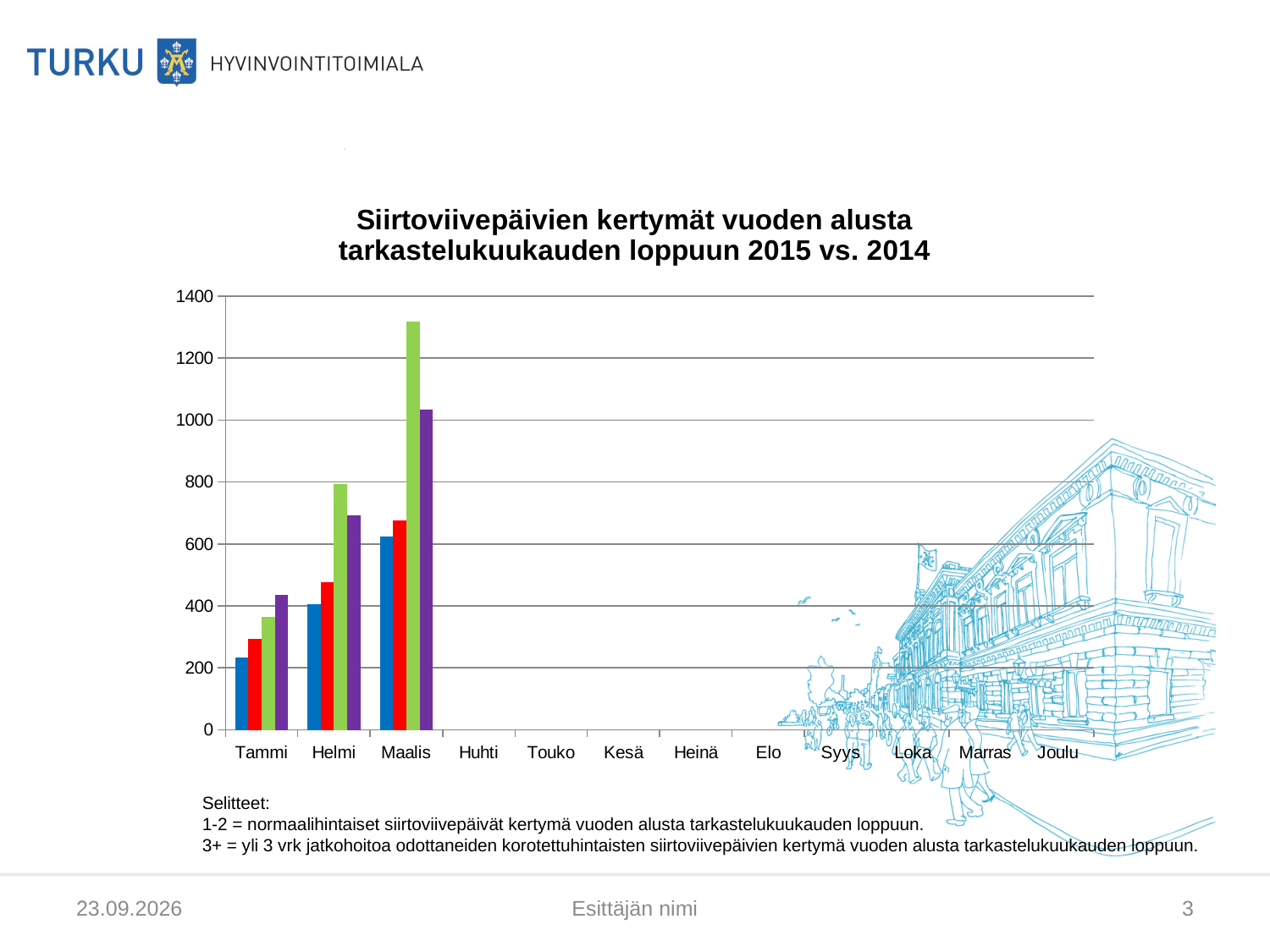
Is the value of the green bar for Maalis greater or less than 1200? greater What is the title of the chart? Siirtoviivepäivien kertymät vuoden alusta tarkastelukuukauden loppuun 2015 vs. 2014 Among the months with data, which month has the lowest bars? Tammi Is the value of the blue bar for Tammi greater or less than 400? less How many months have bars plotted in the chart? 3 Is the value of the blue bar for Maalis greater or less than 400? greater How many month categories are shown on the x axis? 12 What kind of chart is shown on the slide? bar chart Which month has the tallest bar in the chart? Maalis Do the bar values rise or fall from Tammi to Maalis? rise For Maalis, which is larger: the green bar or the purple bar? the green bar